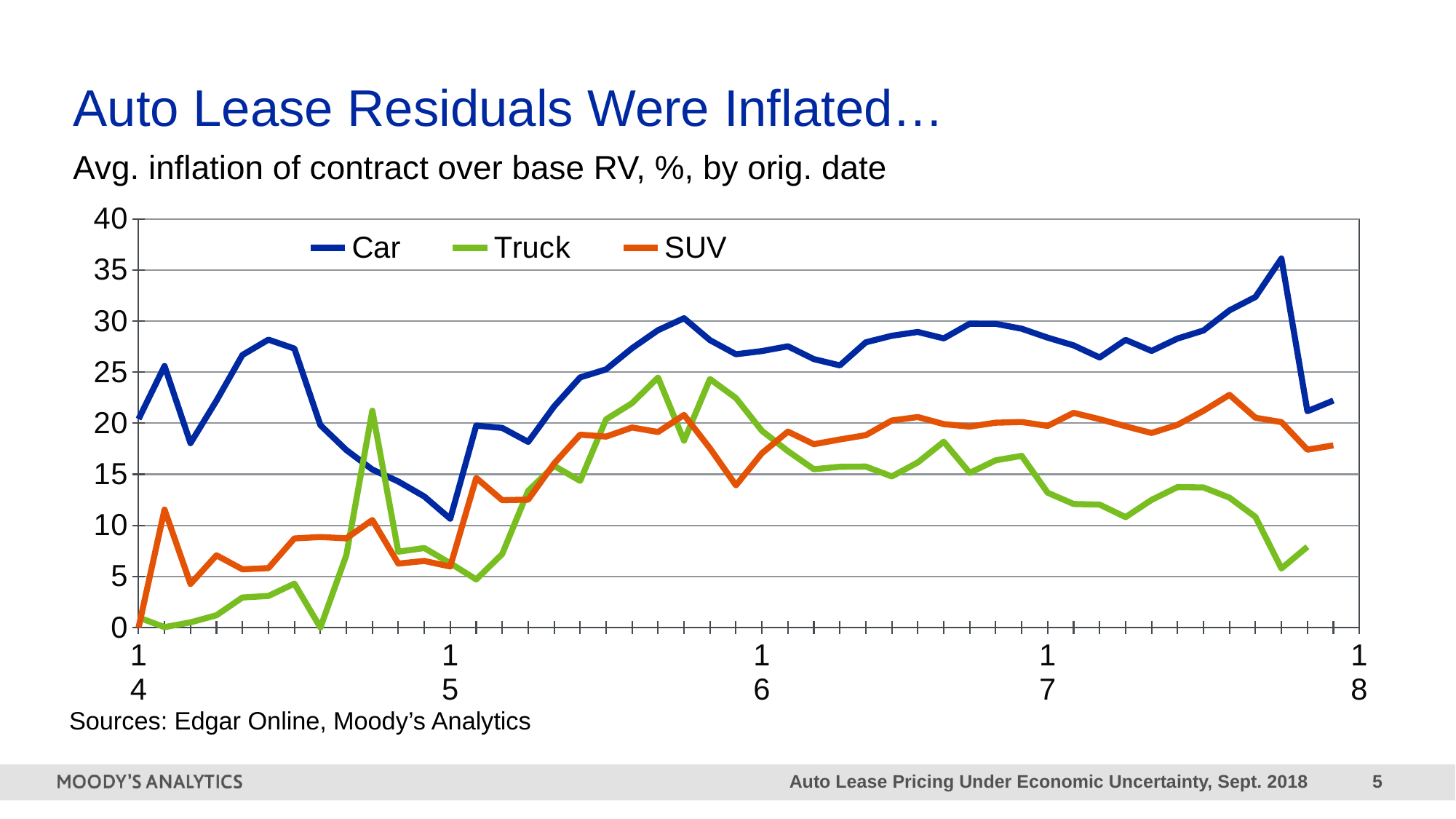
Is the value for Truck at the start of the chart (14) greater or less than 5? less At the right end of the chart (near 18), which series is larger, Car or Truck? Car Which series is drawn in orange? SUV Which series are listed in the legend? Car, Truck, SUV Which series has the lowest value at the right end of the chart (near 18)? Truck Is the lowest value of the Car series greater or less than 15? less Is the peak value of the SUV series greater or less than 20? greater Does the Truck series rise or fall between 16 and 18? fall What kind of chart is shown on the slide? line chart How many series does the legend list? 3 Which series has the highest values across the whole chart? Car